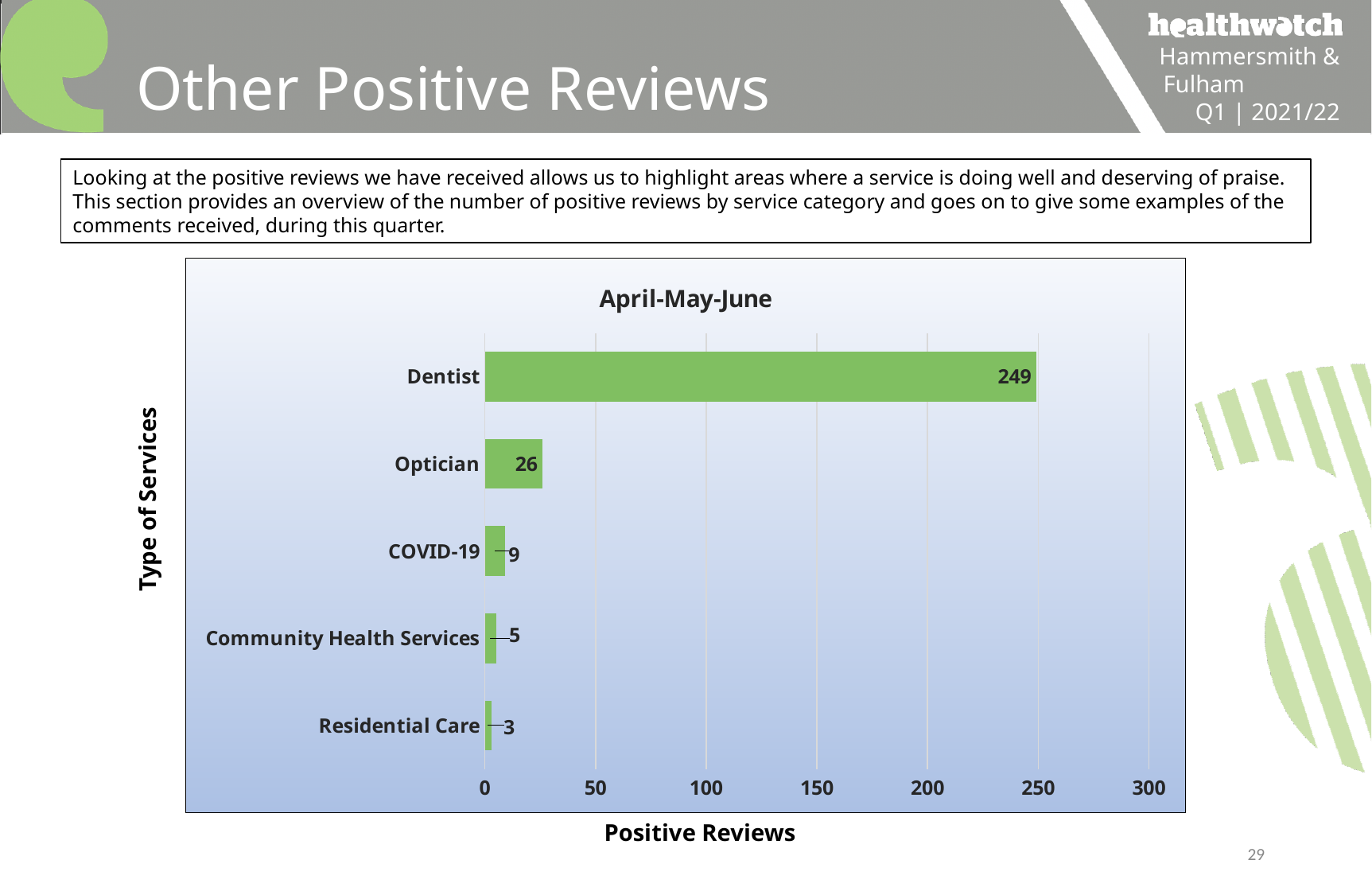
What is the value for Optician in the chart? 26 What is the difference between the positive reviews for Dentist and Optician? 223 How many positive reviews are shown for COVID-19? 9 Is the value for Dentist greater or less than 200? greater Which type of service has the lowest number of positive reviews? Residential Care What kind of chart is shown on the slide? Bar chart What is the title of the chart? April-May-June Which type of service has the highest number of positive reviews? Dentist Which has more positive reviews, Community Health Services or COVID-19? COVID-19 How many types of services are shown in the chart? 5 What is the value for Residential Care? 3 How many positive reviews did Dentist receive in the April-May-June chart? 249